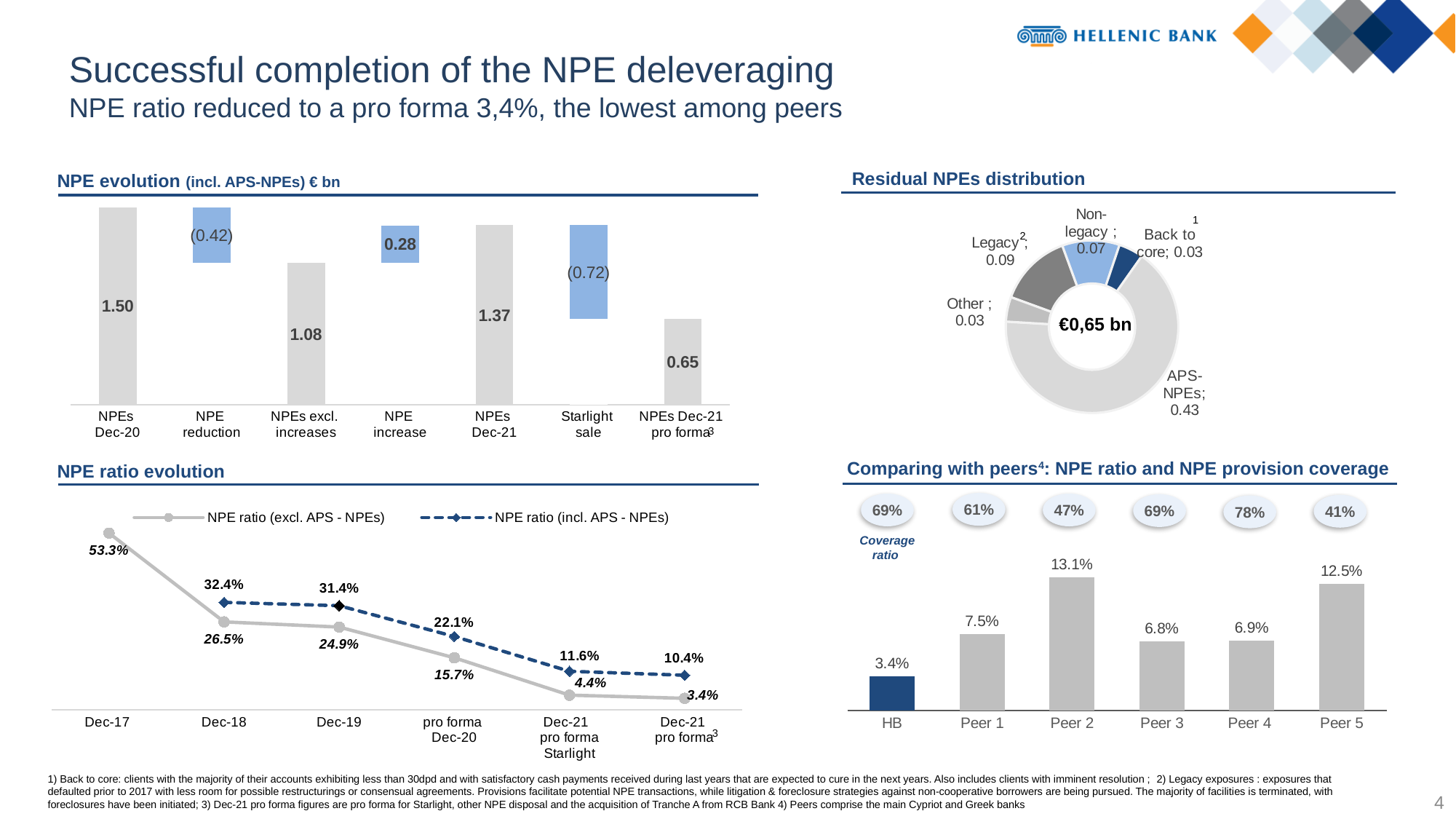
In the NPE ratio evolution chart, do the NPE ratio (excl. APS - NPEs) values rise or fall from Dec-17 to Dec-21 pro forma? fall In the Comparing with peers chart, which bank has the highest NPE ratio? Peer 2 In the NPE ratio evolution chart, what is the NPE ratio (incl. APS - NPEs) at Dec-19? 31.4% In the Residual NPEs distribution chart, what total is shown in the centre of the donut? €0,65 bn How many series does the legend of the NPE ratio evolution chart list? 2 In the Residual NPEs distribution chart, which segment is the largest? APS-NPEs In the NPE evolution chart, what is the value for NPEs Dec-20? 1.50 In the NPE evolution chart, what is the difference between NPEs Dec-20 and NPEs Dec-21? 0.13 In the Comparing with peers chart, what is the NPE ratio for Peer 4? 6.9% What kind of chart is the Comparing with peers chart? bar chart In the Residual NPEs distribution chart, what is the value for APS-NPEs? 0.43 In the NPE evolution chart, what is the value for NPEs Dec-21 pro forma? 0.65